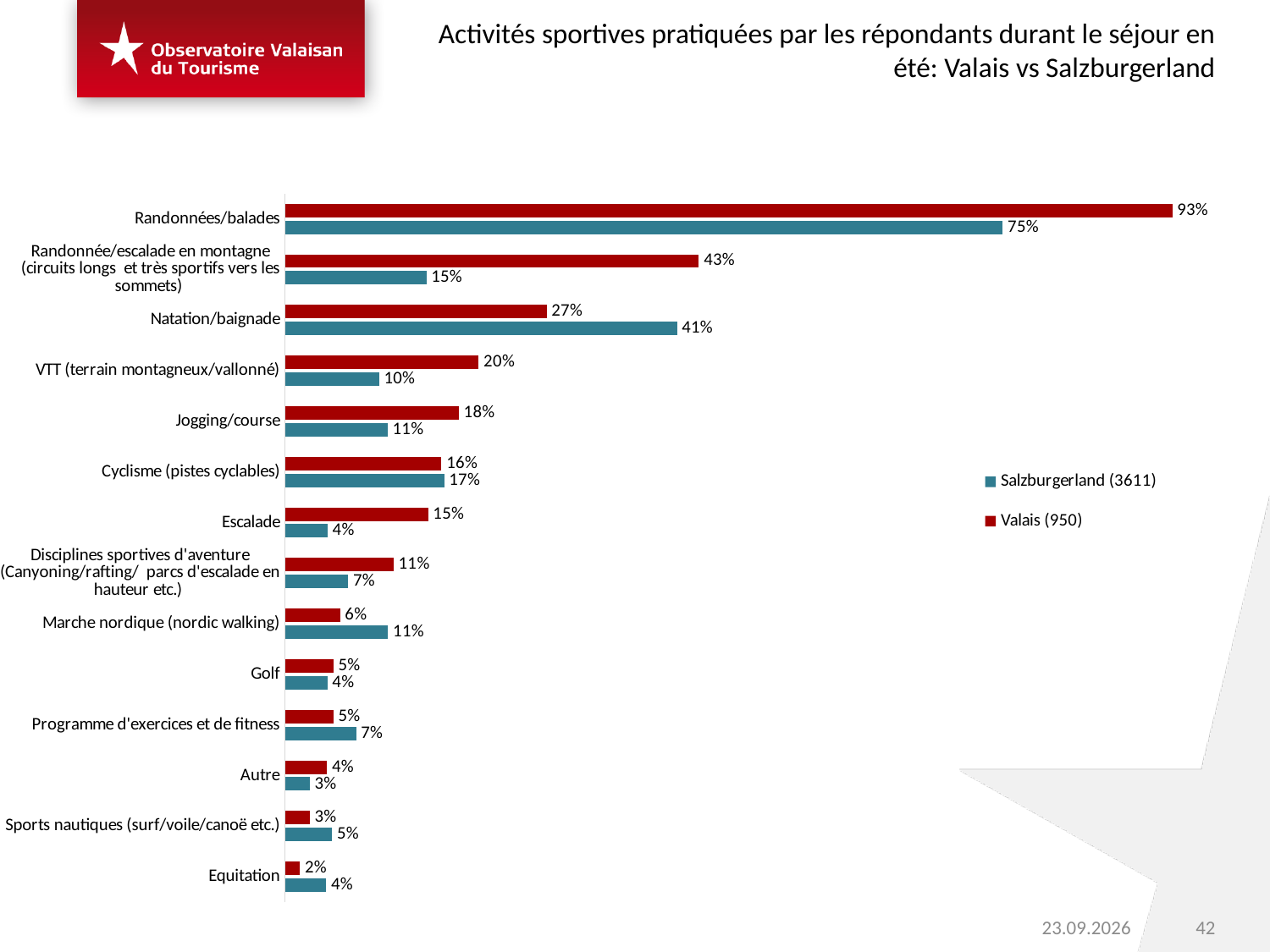
How many series does the legend list? 2 What is the difference between the Salzburgerland and Valais values for Marche nordique (nordic walking)? 5% Which colour represents the Valais (950) series? Red Which activity has the highest value for Valais? Randonnées/balades Which activity has the lowest value for Valais? Equitation What is the Salzburgerland value for Escalade? 4% What percentage of Valais respondents practised Randonnées/balades? 93% Which is larger for Natation/baignade: the Valais value or the Salzburgerland value? Salzburgerland What kind of chart is shown on the slide? Bar chart What is the difference between the Valais and Salzburgerland values for Randonnée/escalade en montagne? 28% How many activity categories are shown on the chart? 14 What percentage of Salzburgerland respondents practised Natation/baignade? 41%